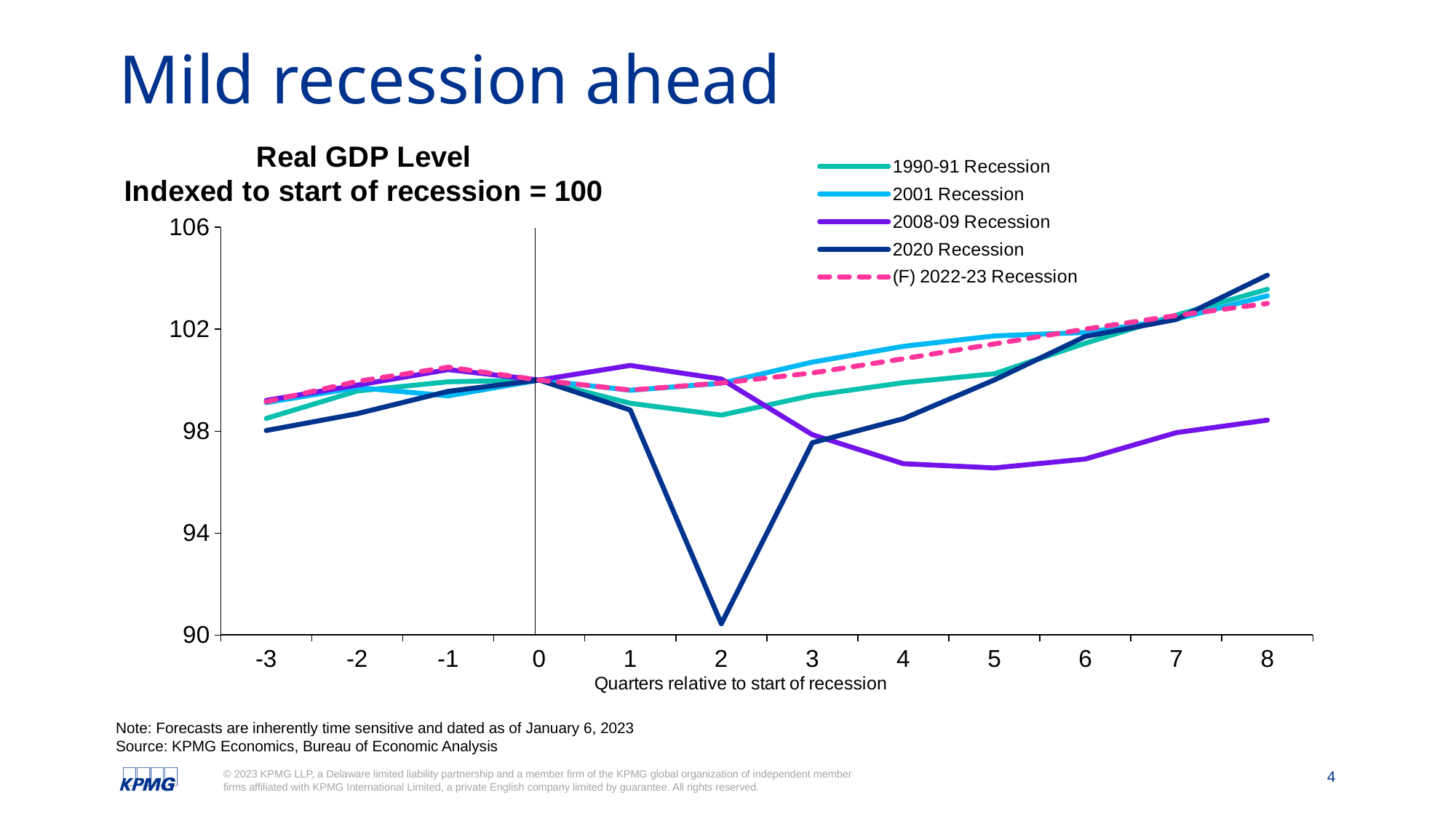
Which series is drawn with a dashed line? (F) 2022-23 Recession How many series does the legend list? 5 Is the value for the 2020 Recession at quarter 8 greater or less than 102? greater What kind of chart is shown on the slide? line chart What is the label of the x axis? Quarters relative to start of recession How many quarters are marked along the x axis? 12 Is the value for the 2020 Recession at quarter 2 greater or less than 94? less Which series has the lowest value at quarter 8? 2008-09 Recession Is the value for the 2008-09 Recession at quarter 5 greater or less than 98? less Which series has the lowest value at quarter 2? 2020 Recession Does the 2008-09 Recession line rise or fall from quarter 1 to quarter 5? fall Which series has the highest value at quarter 1? 2008-09 Recession